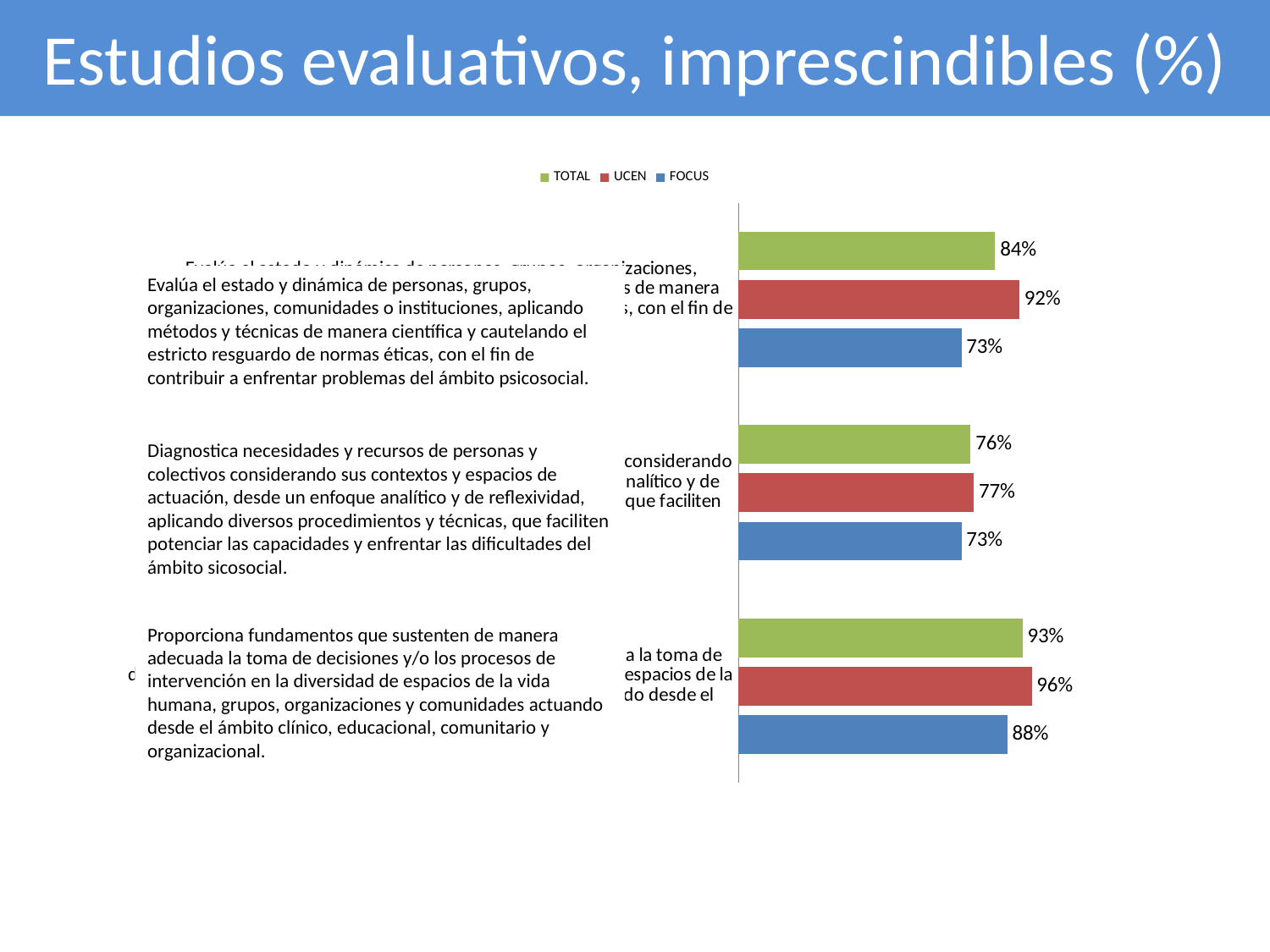
Which series is shown in blue in the legend? FOCUS What is the UCEN value for the category beginning "Evalúa el estado y dinámica de personas"? 92% What is the TOTAL value for the category beginning "Diagnostica necesidades y recursos"? 76% What kind of chart is shown on the slide? Bar chart How many series does the legend list? 3 What is the difference between the UCEN and FOCUS values for the category beginning "Evalúa el estado y dinámica de personas"? 19% For the category beginning "Diagnostica necesidades y recursos", which is larger: the UCEN value or the FOCUS value? UCEN What is the difference between the TOTAL values for the "Proporciona fundamentos" category and the "Evalúa el estado" category? 9% What is the FOCUS value for the category beginning "Proporciona fundamentos que sustenten"? 88% Which category has the lowest TOTAL value? Diagnostica necesidades y recursos de personas y colectivos... Which category has the highest UCEN value? Proporciona fundamentos que sustenten de manera adecuada la toma de decisiones... How many categories are shown in the chart? 3